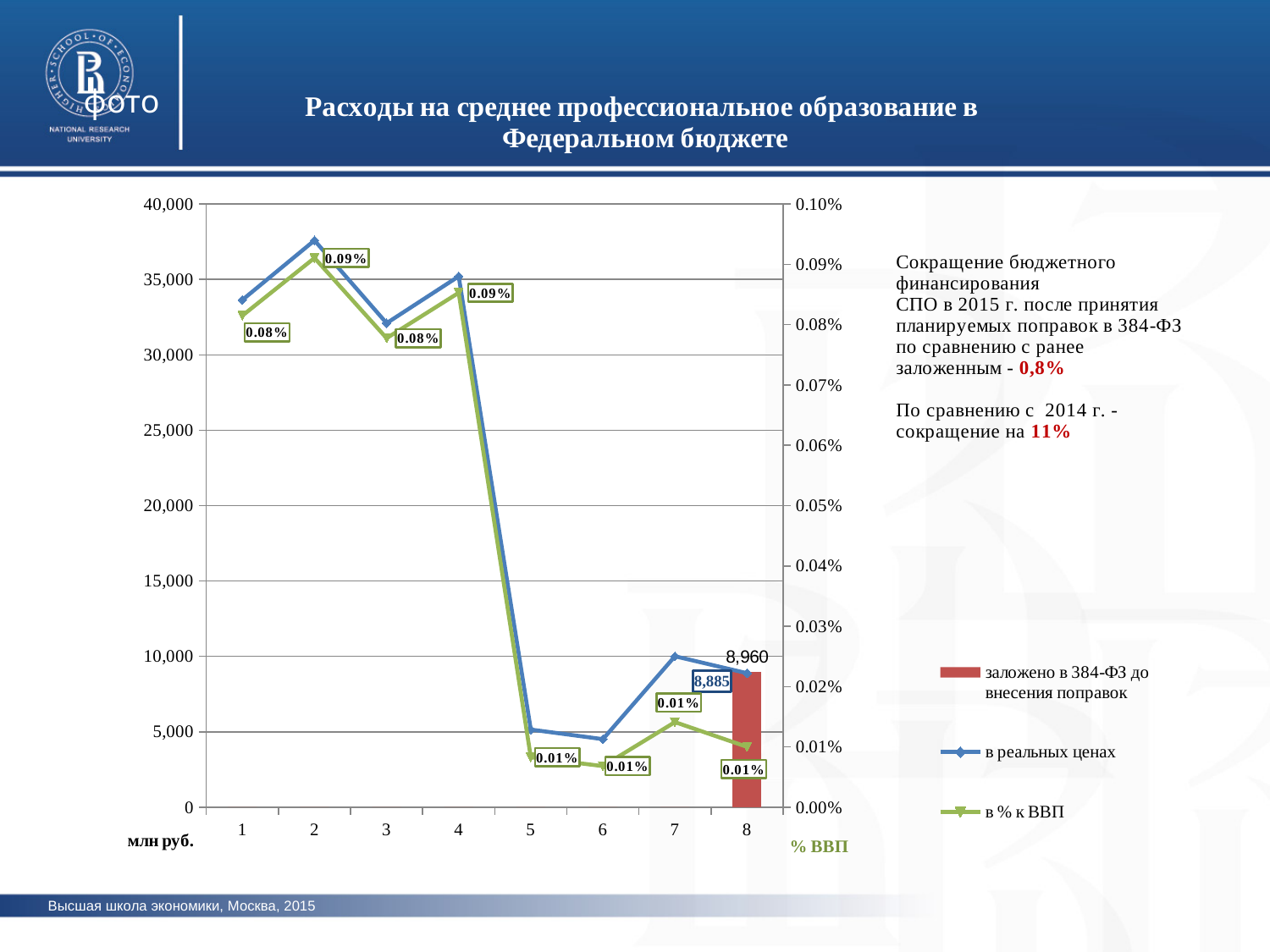
Which category has the highest value for the "в реальных ценах" series? 2 What is the value of the "заложено в 384-ФЗ до внесения поправок" bar for category 8? 8,960 How many series does the legend list? 3 What is the value of the "в % к ВВП" series for category 2? 0.09% Does the "в реальных ценах" series rise or fall from category 4 to category 5? fall How many categories are shown on the x axis? 8 What kind of chart is this? Combined line and bar chart What is the value of the "в реальных ценах" series for category 8? 8,885 For category 8, which is larger: the "заложено в 384-ФЗ до внесения поправок" value or the "в реальных ценах" value? заложено в 384-ФЗ до внесения поправок What is the value of the "в % к ВВП" series for category 5? 0.01% For category 8, what is the difference between the "заложено в 384-ФЗ до внесения поправок" value and the "в реальных ценах" value? 75 Is the value of "в реальных ценах" for category 2 greater or less than 35,000? greater